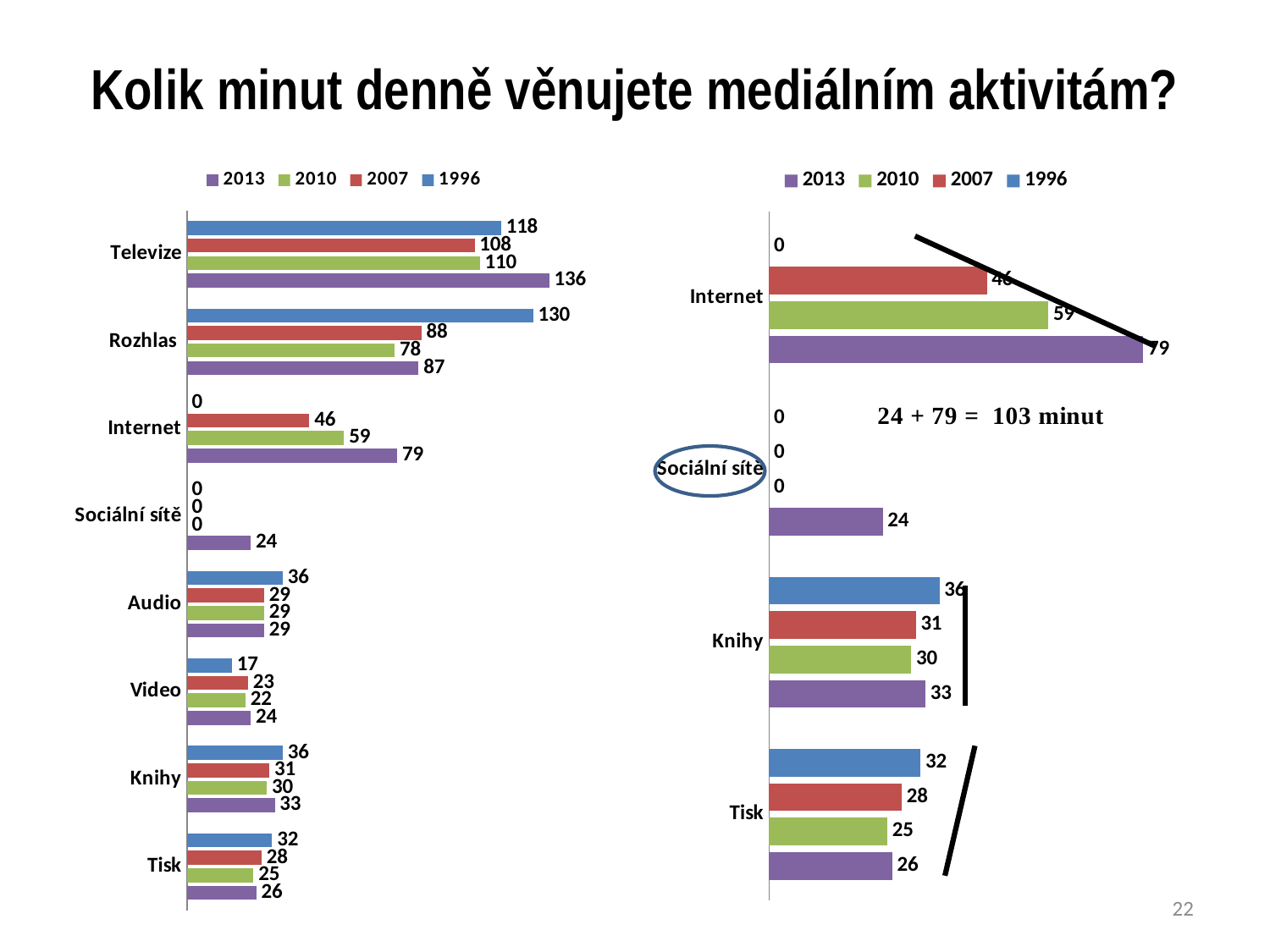
In the left chart, which category has the highest value for 2013? Televize What type of chart is the left chart? Bar chart In the right chart, which is larger for Knihy: the 1996 value or the 2013 value? 1996 How many categories does the left chart show? 8 In the left chart, which category has the lowest value for 1996? Internet and Sociální sítě (both 0) In the left chart, what is the difference between the 2013 and 1996 values for Televize? 18 How many series does the legend of the right chart list? 4 In the right chart, what is the value for Internet in 2010? 59 In the right chart, what is the value for Sociální sítě in 2013? 24 How many categories does the right chart show? 4 In the left chart, what is the value for Rozhlas in 1996? 130 In the left chart, what is the value for Televize in 2013? 136